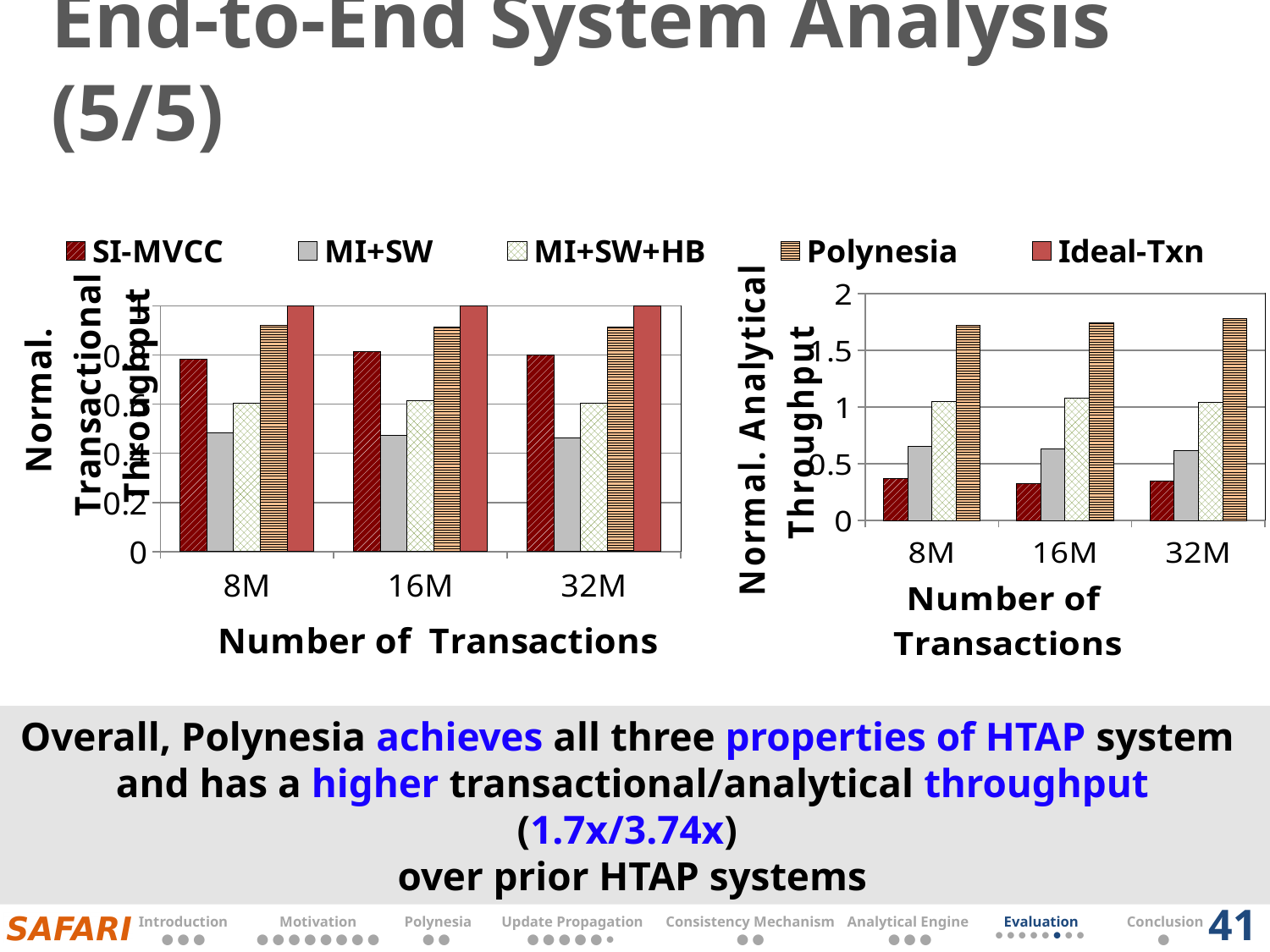
In the Normal. Transactional Throughput chart on the left, which series has the lowest bar at 32M? MI+SW How many categories are shown on the x axis of the Normal. Analytical Throughput chart on the right? 3 What kind of chart is the Normal. Transactional Throughput chart on the left? bar chart In the Normal. Analytical Throughput chart on the right, which series has the lowest bar at 16M? SI-MVCC In the Normal. Analytical Throughput chart on the right, is the value for SI-MVCC at 32M greater or less than 0.5? less In the Normal. Analytical Throughput chart on the right, which is larger at 8M: Polynesia or MI+SW? Polynesia In the Normal. Analytical Throughput chart on the right, is the value for Polynesia at 8M greater or less than 1.5? greater In the Normal. Analytical Throughput chart on the right, which series has the highest bar at 8M? Polynesia In the Normal. Transactional Throughput chart on the left, which series has the highest bar at 16M? Ideal-Txn What is the x-axis title of the Normal. Transactional Throughput chart on the left? Number of Transactions In the Normal. Transactional Throughput chart on the left, which is larger at 8M: SI-MVCC or MI+SW? SI-MVCC How many series does the legend at the top of the slide list? 5